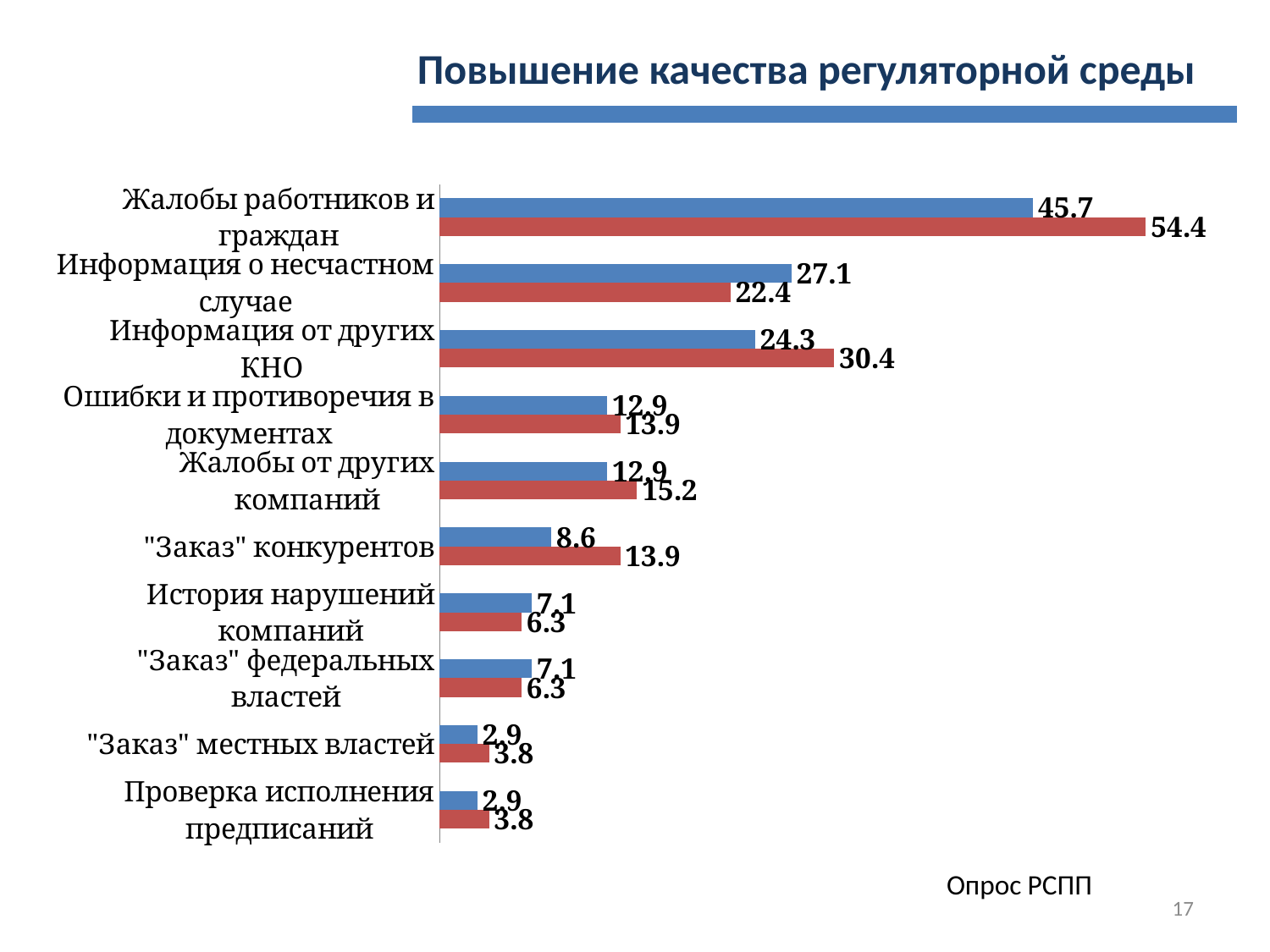
What is the value of the blue bar for ""Заказ" конкурентов"? 8.6 Which category has the longest red bar? Жалобы работников и граждан What kind of chart is shown on the slide? Bar chart What is the value of the blue bar for "Жалобы работников и граждан"? 45.7 What is the difference between the red and blue bars for ""Заказ" конкурентов"? 5.3 How many categories are plotted on the chart? 10 What is the value of the red bar for "Информация от других КНО"? 30.4 By how much does the red bar exceed the blue bar for "Жалобы работников и граждан"? 8.7 What is the title of the slide? Повышение качества регуляторной среды What is the value of the red bar for ""Заказ" местных властей"? 3.8 What is the value of the red bar for "Жалобы работников и граждан"? 54.4 For "Информация о несчастном случае", which bar is larger, the blue one or the red one? The blue one